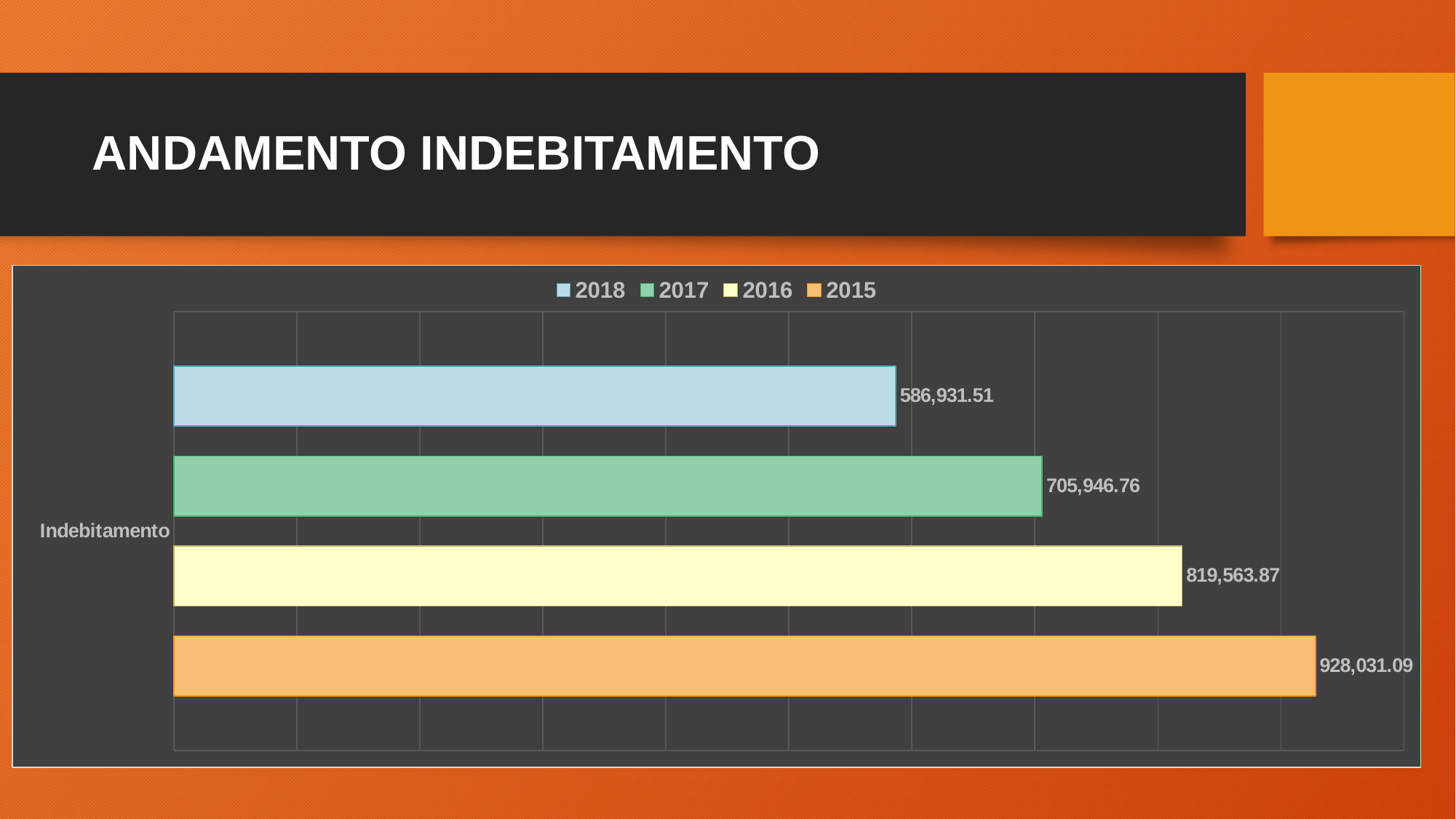
How many series does the legend list? 4 What is the difference between the 2016 and 2017 Indebitamento values? 113,617.11 What is the value for 2015 in the Indebitamento chart? 928,031.09 What kind of chart is shown on the slide? Bar chart Which year has the highest Indebitamento value? 2015 What is the value for 2016 in the Indebitamento chart? 819,563.87 What is the value for 2018 in the Indebitamento chart? 586,931.51 What is the difference between the 2015 and 2018 Indebitamento values? 341,099.58 Which is larger, the Indebitamento value for 2017 or for 2016? 2016 Which year has the lowest Indebitamento value? 2018 What is the value for 2017 in the Indebitamento chart? 705,946.76 Does the Indebitamento value rise or fall from 2015 to 2018? Fall